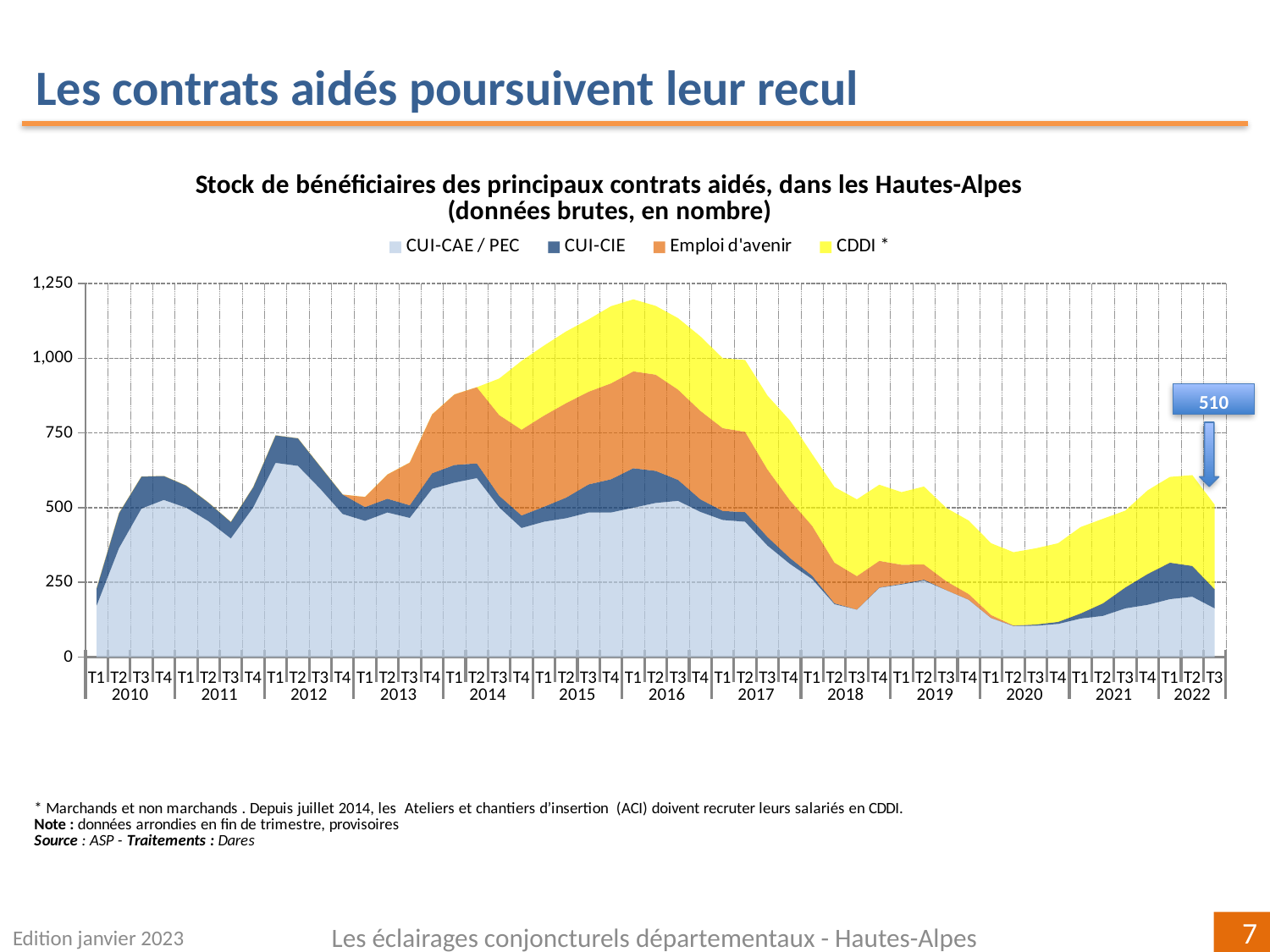
Is the total stock at T2 2020 greater or less than 500? less Which series is at the bottom of the stack? CUI-CAE / PEC What total value is indicated by the callout for T3 2022? 510 In which year does the total stock reach its highest peak? 2016 Is the total stock at T1 2012 greater or less than 500? greater Which series is shown in yellow? CDDI * How many series does the legend list? 4 Does the total stock rise or fall between 2016 and 2020? fall Is the total stock at T1 2010 greater or less than 250? less How many years are shown on the x axis? 13 What kind of chart is shown on the slide? stacked area chart